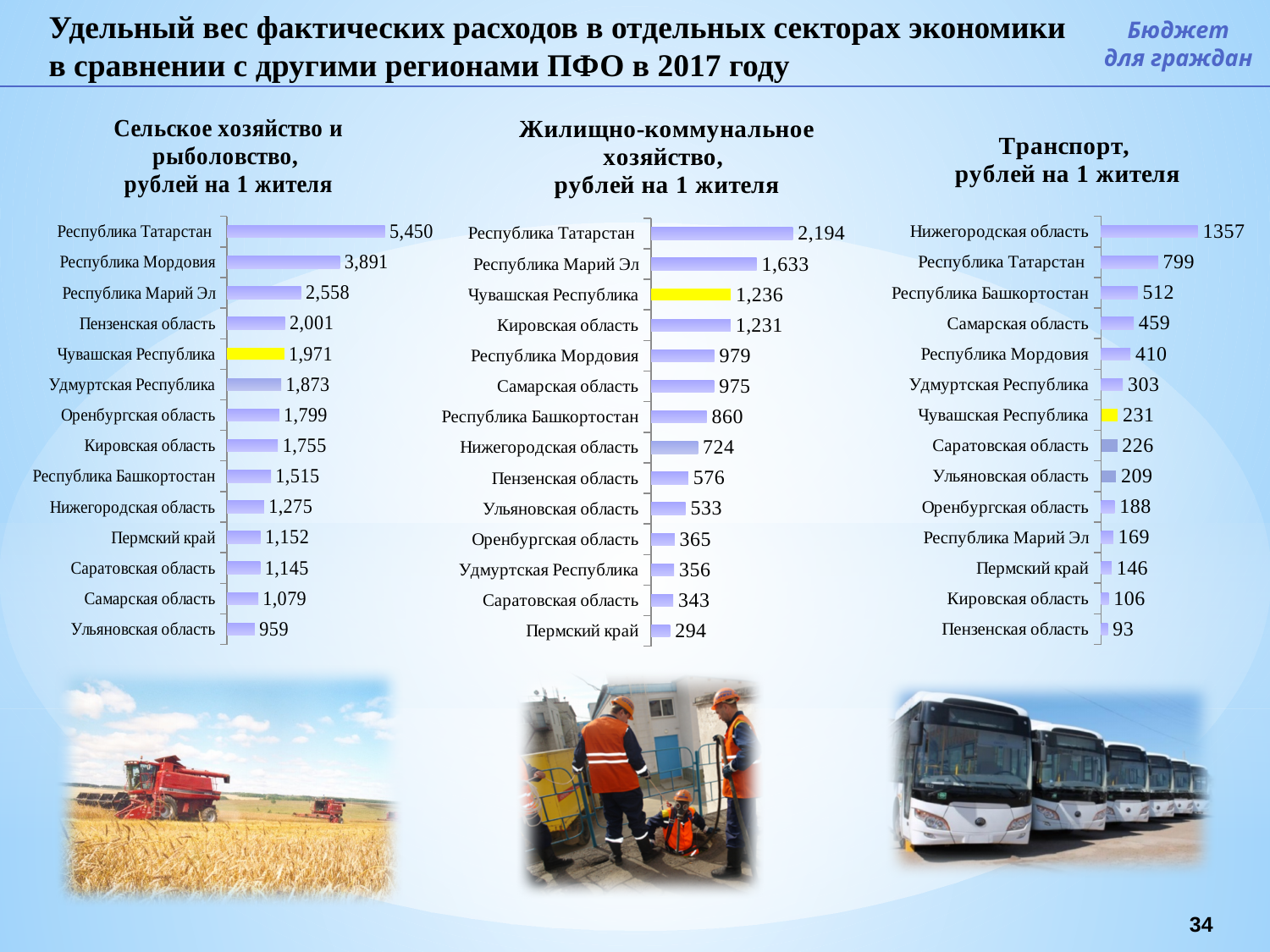
In the chart 'Сельское хозяйство и рыболовство, рублей на 1 жителя', which region has the highest value? Республика Татарстан In the chart 'Транспорт, рублей на 1 жителя', what is the value for Самарская область? 459 What type of chart is the 'Транспорт, рублей на 1 жителя' chart? Bar chart In the chart 'Жилищно-коммунальное хозяйство, рублей на 1 жителя', which is larger: Республика Марий Эл or Республика Мордовия? Республика Марий Эл In the chart 'Сельское хозяйство и рыболовство, рублей на 1 жителя', which region has the lowest value? Ульяновская область In the chart 'Транспорт, рублей на 1 жителя', which region has the highest value? Нижегородская область In the chart 'Сельское хозяйство и рыболовство, рублей на 1 жителя', what is the difference between Республика Татарстан and Республика Мордовия? 1,559 In the chart 'Транспорт, рублей на 1 жителя', what is the difference between Республика Татарстан and Чувашская Республика? 568 In the chart 'Жилищно-коммунальное хозяйство, рублей на 1 жителя', how many regions are shown? 14 In the chart 'Сельское хозяйство и рыболовство, рублей на 1 жителя', what is the value for Чувашская Республика? 1,971 In the chart 'Жилищно-коммунальное хозяйство, рублей на 1 жителя', which region has the lowest value? Пермский край In the chart 'Жилищно-коммунальное хозяйство, рублей на 1 жителя', what is the value for Кировская область? 1,231